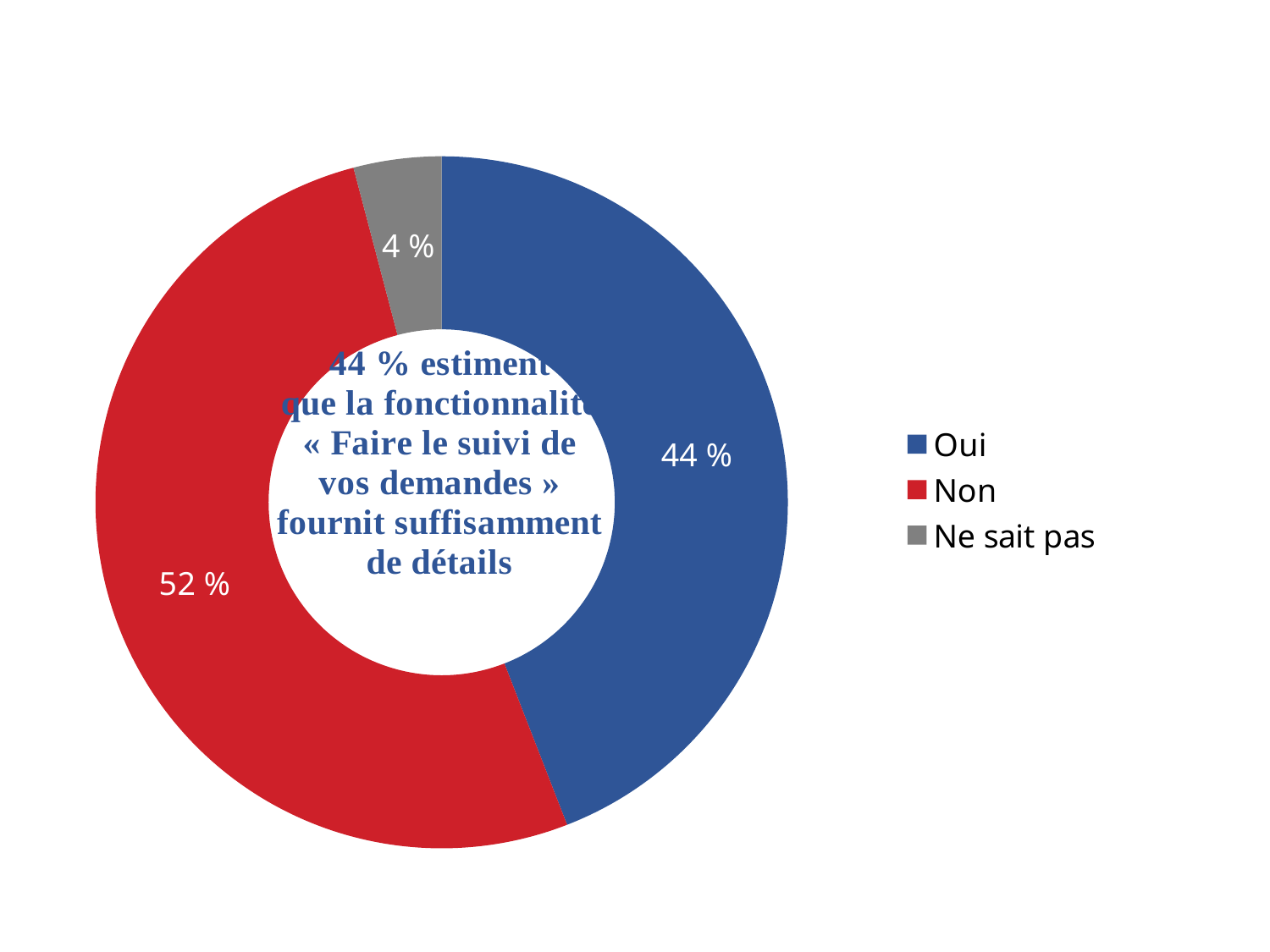
What is the difference in percentage points between the "Non" and "Oui" shares? 8 How many entries does the legend list? 3 What share of respondents answered "Oui"? 44 % What kind of chart is shown on the slide? Pie chart (doughnut) Which response has the smallest share of the chart? Ne sait pas What colour represents "Oui" in the chart? Blue Which response has the largest share of the chart? Non Which is larger, the share for "Oui" or the share for "Non"? Non What colour represents "Ne sait pas" in the chart? Grey How many categories does the chart show? 3 What share of respondents answered "Non"? 52 % What share of respondents answered "Ne sait pas"? 4 %